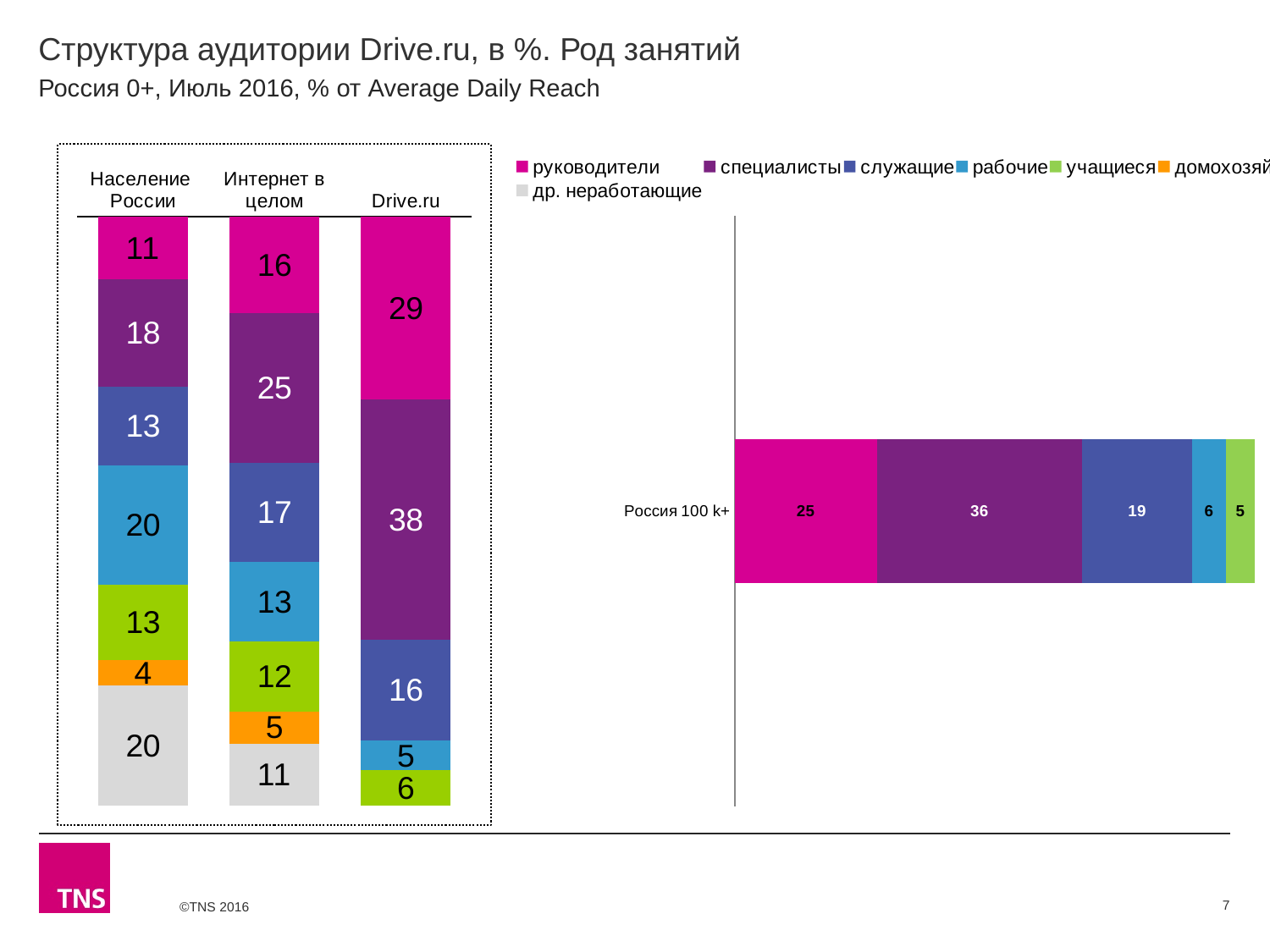
On the right chart, what is the value for специалисты for Россия 100 k+? 36 On the left chart, which bar has the highest value for руководители? Drive.ru On the left chart, which is larger: the служащие value for Интернет в целом or for Drive.ru? Интернет в целом What kind of chart is the chart on the right? Stacked bar chart On the left chart, what is the value for рабочие in the Интернет в целом bar? 13 On the left chart, what is the value for специалисты in the Drive.ru bar? 38 How many series does the legend list? 7 On the right chart, what is the total of the Россия 100 k+ bar? 91 On the left chart, what is the value for руководители in the Население России bar? 11 On the left chart, what is the difference between the специалисты values for Drive.ru and Интернет в целом? 13 On the left chart, how many bars (categories) are shown? 3 On the right chart, which segment of the Россия 100 k+ bar is the smallest? учащиеся